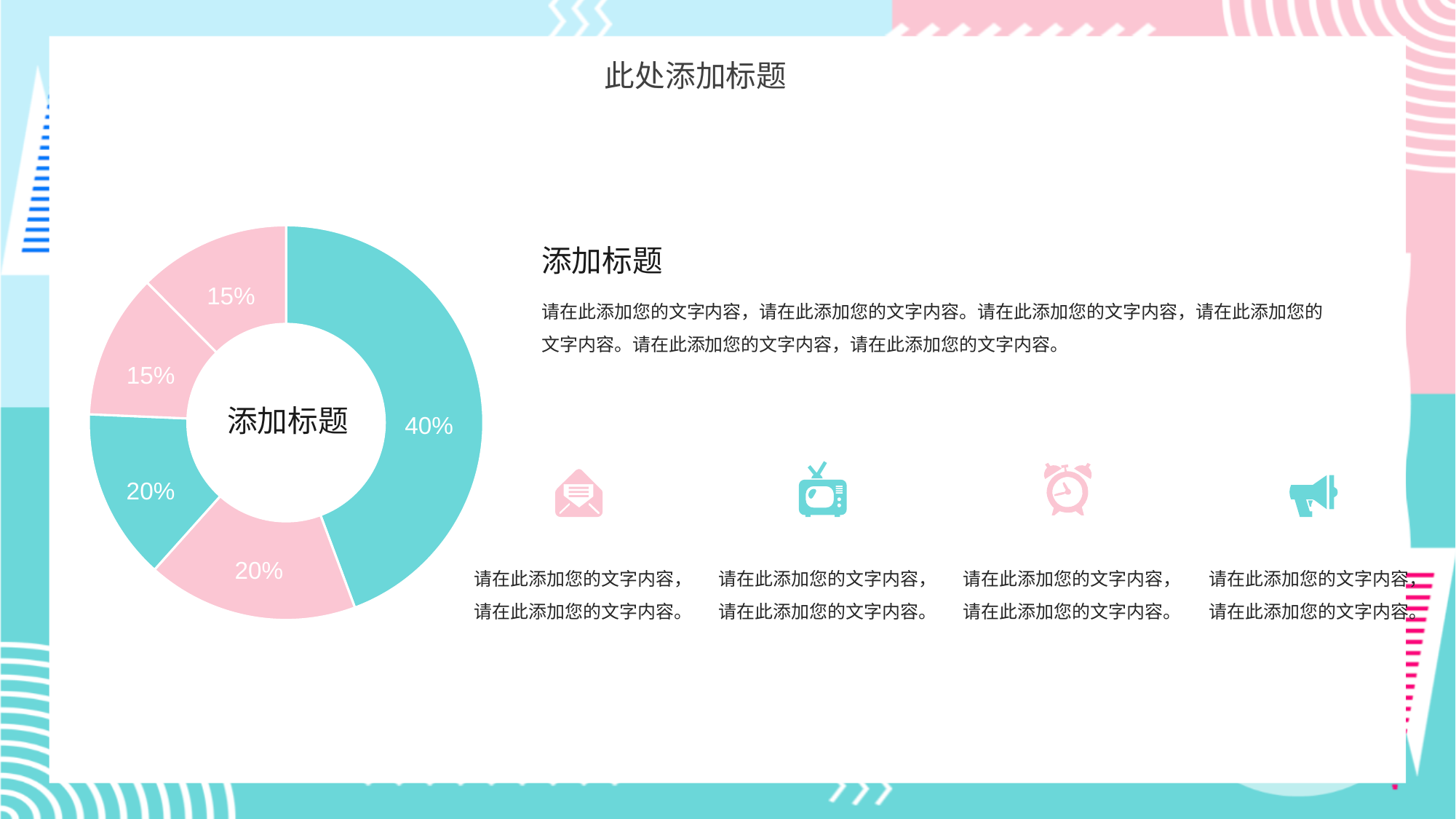
What text appears in the centre of the donut chart? 添加标题 What is the difference between the largest slice (40%) and one of the smallest slices (15%)? 25% How many slices in the donut chart are labelled 20%? 2 What is the value of the largest slice in the donut chart? 40% How many slices does the donut chart have? 5 What value is labelled on the large teal slice on the right side of the donut chart? 40% What is the value of the smallest slices in the donut chart? 15% How many slices in the donut chart are labelled 15%? 2 Which is larger: the large teal slice on the right or the teal slice on the left? The large teal slice on the right (40%) What value is labelled on the teal slice on the left side of the donut chart? 20% What kind of chart is shown on the slide? Pie chart (donut) What colour is the largest slice of the donut chart? Teal